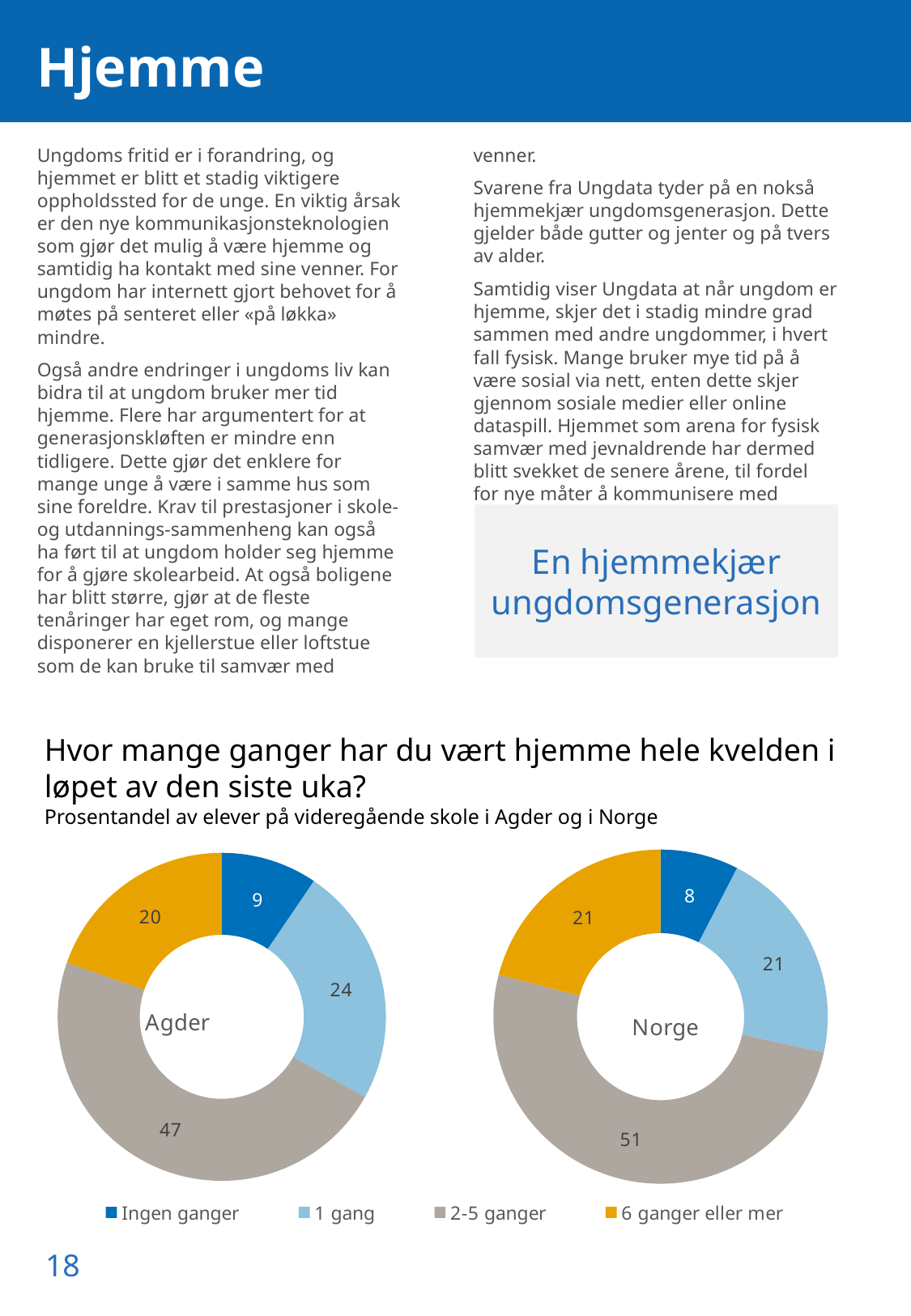
What is the difference between the '2-5 ganger' values in the Norge chart and the Agder chart? 4 In the Norge chart, what is the value for 'Ingen ganger'? 8 What type of chart is used for Agder and Norge? Doughnut chart Which colour represents '6 ganger eller mer' in the charts? Orange/yellow In the Norge chart, which category has the smallest share? Ingen ganger In the Agder chart, what is the value for '2-5 ganger'? 47 In the Agder chart, what is the value for '6 ganger eller mer'? 20 Which is larger: '1 gang' in the Agder chart or '1 gang' in the Norge chart? Agder How many entries does the legend list? 4 In the Agder chart, which category has the largest share? 2-5 ganger In the Norge chart, what is the value for '1 gang'? 21 How many categories does each doughnut chart show? 4